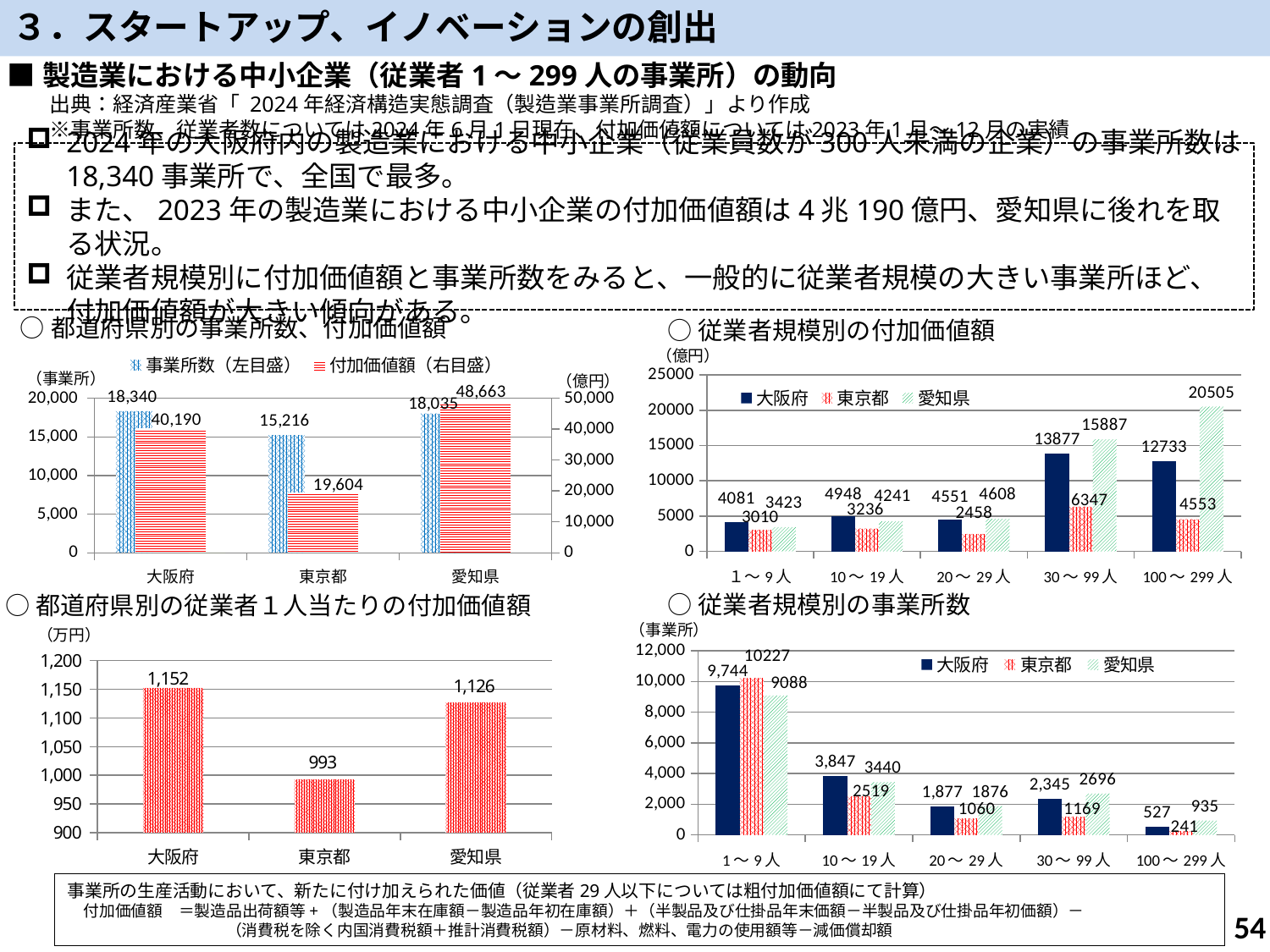
「都道府県別の従業者1人当たりの付加価値額」のグラフで、東京都の値はいくらですか？ 993 「都道府県別の事業所数、付加価値額」のグラフで、付加価値額が最も大きい都道府県はどこですか？ 愛知県 「都道府県別の従業者1人当たりの付加価値額」のグラフで、最も値が小さい都道府県はどこですか？ 東京都 「都道府県別の事業所数、付加価値額」のグラフで、愛知県と東京都の付加価値額の差はいくらですか？ 29,059 「従業者規模別の付加価値額」のグラフで、愛知県の100～299人の付加価値額はいくらですか？ 20505 「従業者規模別の付加価値額」のグラフで、30～99人の大阪府と東京都では、どちらの付加価値額が大きいですか？ 大阪府 「都道府県別の事業所数、付加価値額」のグラフの凡例には、いくつの系列がありますか？ 2 「都道府県別の従業者1人当たりの付加価値額」のグラフは、どのような種類のグラフですか？ 棒グラフ 「都道府県別の事業所数、付加価値額」のグラフで、大阪府の事業所数はいくつですか？ 18,340 「従業者規模別の事業所数」のグラフで、大阪府の100～299人と東京都の100～299人の事業所数の差はいくつですか？ 286 「従業者規模別の事業所数」のグラフで、東京都の1～9人の事業所数はいくつですか？ 10227 「従業者規模別の付加価値額」のグラフには、従業者規模の区分がいくつありますか？ 5